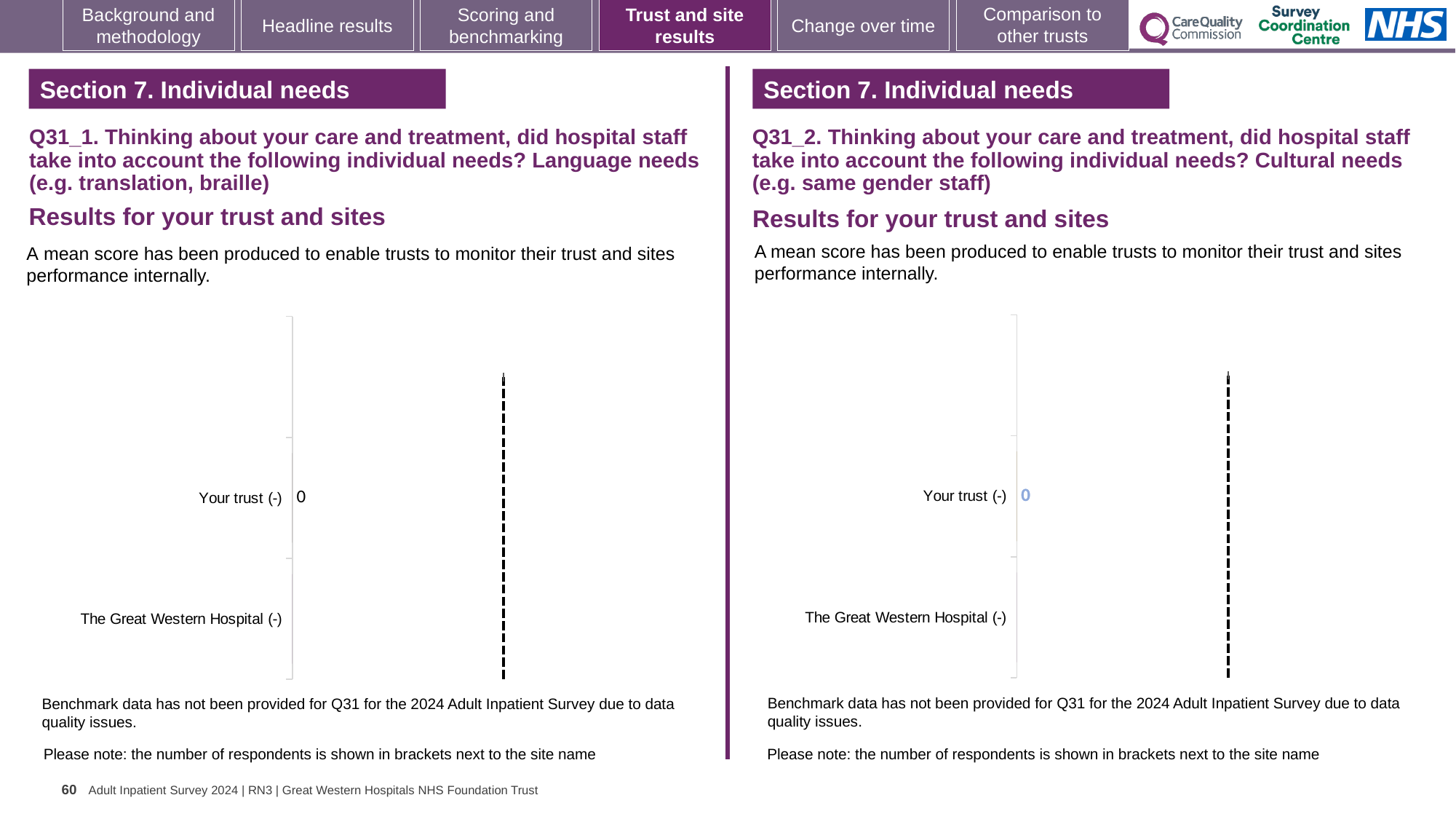
How many categories are listed on the vertical axis of the left chart (Q31_1, Language needs)? 2 In the left chart (Q31_1, Language needs), what value is shown for Your trust? 0 Which individual need does the question for the right chart (Q31_2) ask about? Cultural needs (e.g. same gender staff) In the right chart (Q31_2, Cultural needs), what value is shown for Your trust? 0 How many categories are listed on the vertical axis of the right chart (Q31_2, Cultural needs)? 2 In the left chart (Q31_1, Language needs), what is the label of the second category on the vertical axis? The Great Western Hospital (-) What kind of chart is the left chart (Q31_1, Language needs)? Bar chart What kind of chart is the right chart (Q31_2, Cultural needs)? Bar chart